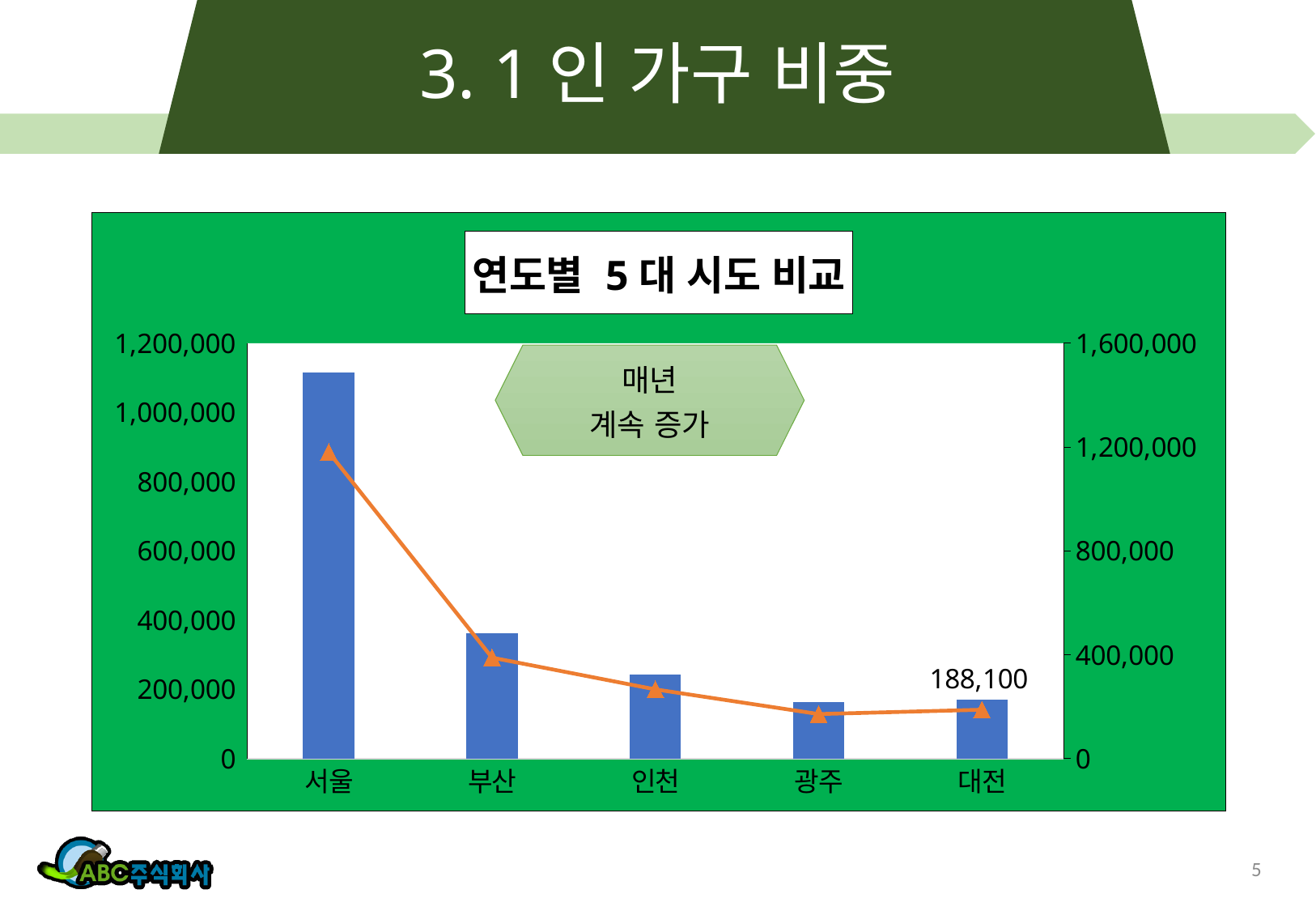
What value is printed as a data label above the 대전 point on the line? 188,100 What is the title of the chart? 연도별 5 대 시도 비교 What is the highest tick value shown on the right-hand axis of the chart? 1,600,000 Is the bar value for 광주 on the left axis greater or less than 200,000? less Which has the taller bar, 부산 or 인천? 부산 Which city has the tallest bar in the chart? 서울 How many cities are shown on the x axis of the chart? 5 Is the bar value for 서울 on the left axis greater or less than 1,000,000? greater Is the bar value for 부산 on the left axis greater or less than 400,000? less What kind of chart is shown on the slide? A combined bar and line chart Do the bar values generally rise or fall moving from 서울 to 대전 along the x axis? fall